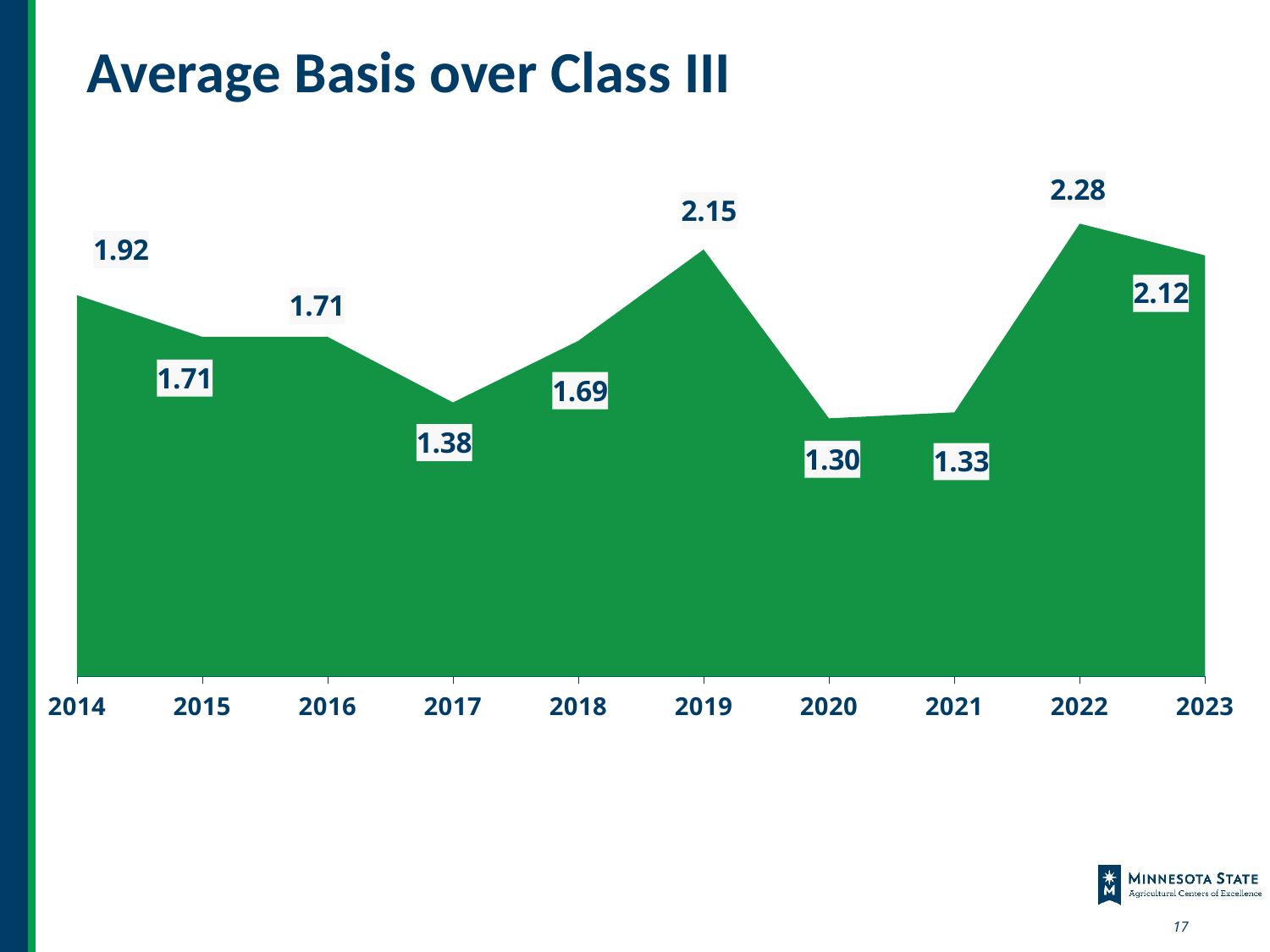
Which year has a larger average basis over Class III, 2014 or 2016? 2014 What is the average basis over Class III for 2023? 2.12 Which year has the highest average basis over Class III? 2022 What kind of chart is shown on the slide? Area chart Does the average basis over Class III rise or fall from 2019 to 2020? Fall What is the average basis over Class III for 2017? 1.38 What is the difference between the average basis in 2022 and in 2020? 0.98 What is the difference between the average basis in 2019 and in 2018? 0.46 How many years are shown on the x axis of the chart? 10 Which year has a larger average basis over Class III, 2021 or 2023? 2023 Which year has the lowest average basis over Class III? 2020 What is the average basis over Class III for 2019? 2.15